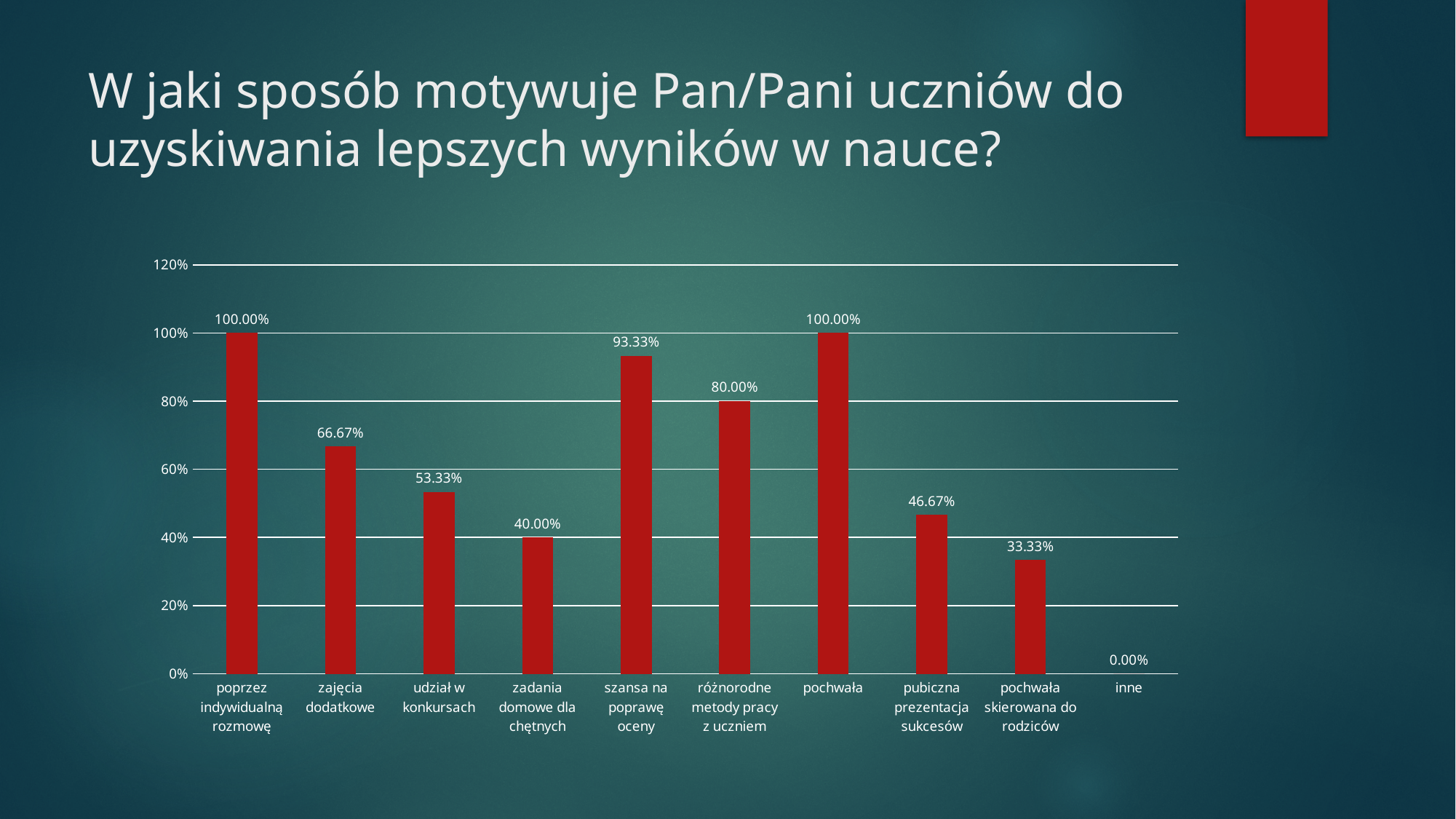
How many categories are shown on the x axis? 10 What is the value for "szansa na poprawę oceny"? 93.33% What is the value for "zajęcia dodatkowe"? 66.67% What is the value for "inne"? 0.00% Is the value for "różnorodne metody pracy z uczniem" greater or less than 60%? greater Which category has the lowest value? inne What kind of chart is shown on the slide? bar chart Which categories share the highest value of 100.00%? poprzez indywidualną rozmowę and pochwała What is the difference between the values for "różnorodne metody pracy z uczniem" and "zadania domowe dla chętnych"? 40.00% What is the title of the slide? W jaki sposób motywuje Pan/Pani uczniów do uzyskiwania lepszych wyników w nauce? What is the value for "pochwała skierowana do rodziców"? 33.33% Which is larger, the value for "udział w konkursach" or the value for "pubiczna prezentacja sukcesów"? udział w konkursach